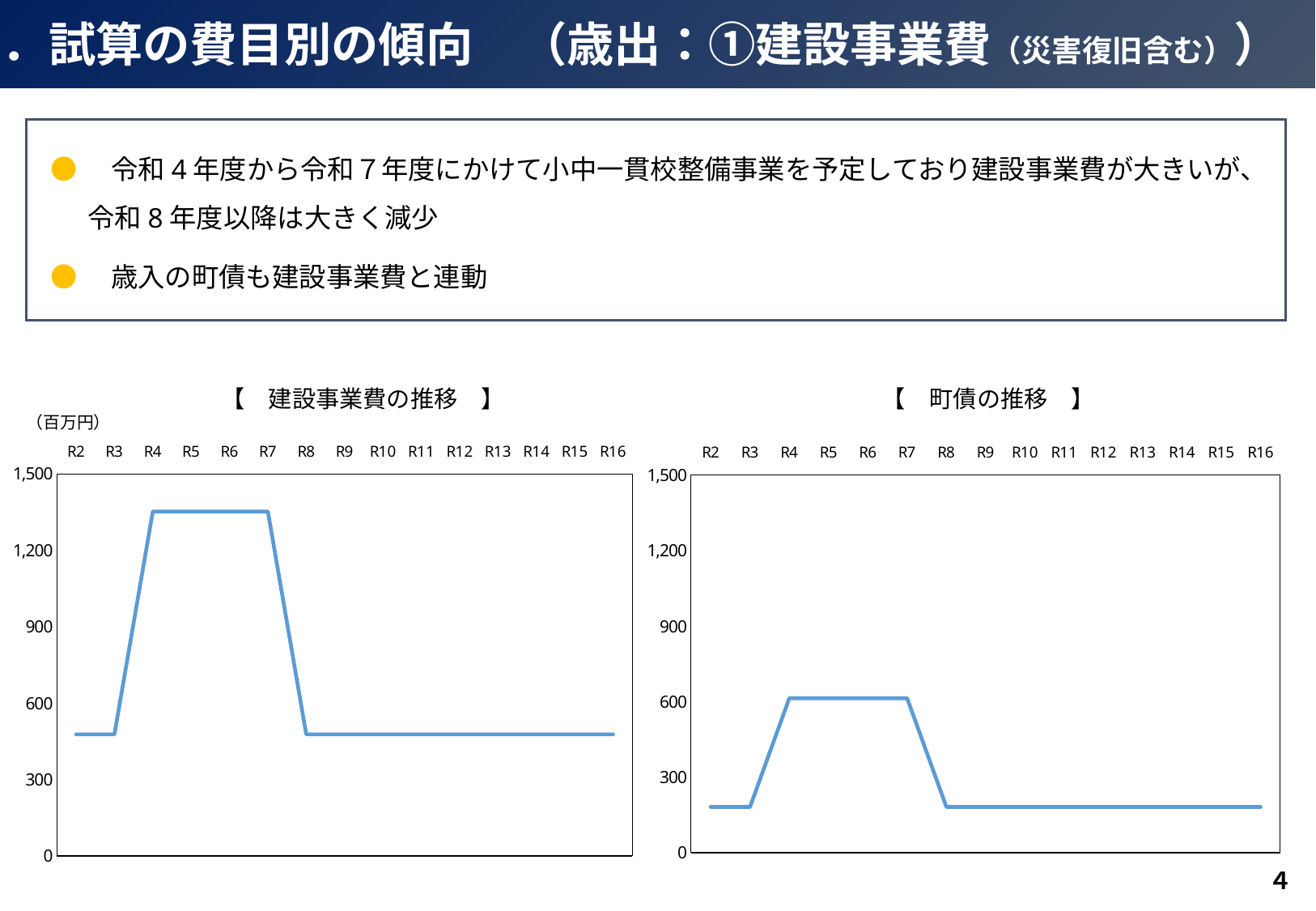
In the 建設事業費の推移 chart, which is larger, the value for R5 or the value for R10? R5 In the 建設事業費の推移 chart, is the value for R2 greater or less than 300? greater In the 建設事業費の推移 chart, does the line rise or fall between R7 and R8? fall In the 町債の推移 chart, does the line rise or fall between R3 and R4? rise In the 町債の推移 chart, which is larger, the value for R3 or the value for R6? R6 In the 建設事業費の推移 chart, is the value for R10 greater or less than 600? less What unit is shown for the y axis of the 建設事業費の推移 chart? 百万円 In the 町債の推移 chart, is the value for R5 greater or less than 300? greater How many years are plotted on the x axis of the 町債の推移 chart? 15 What kind of chart is the 建設事業費の推移 chart? line chart